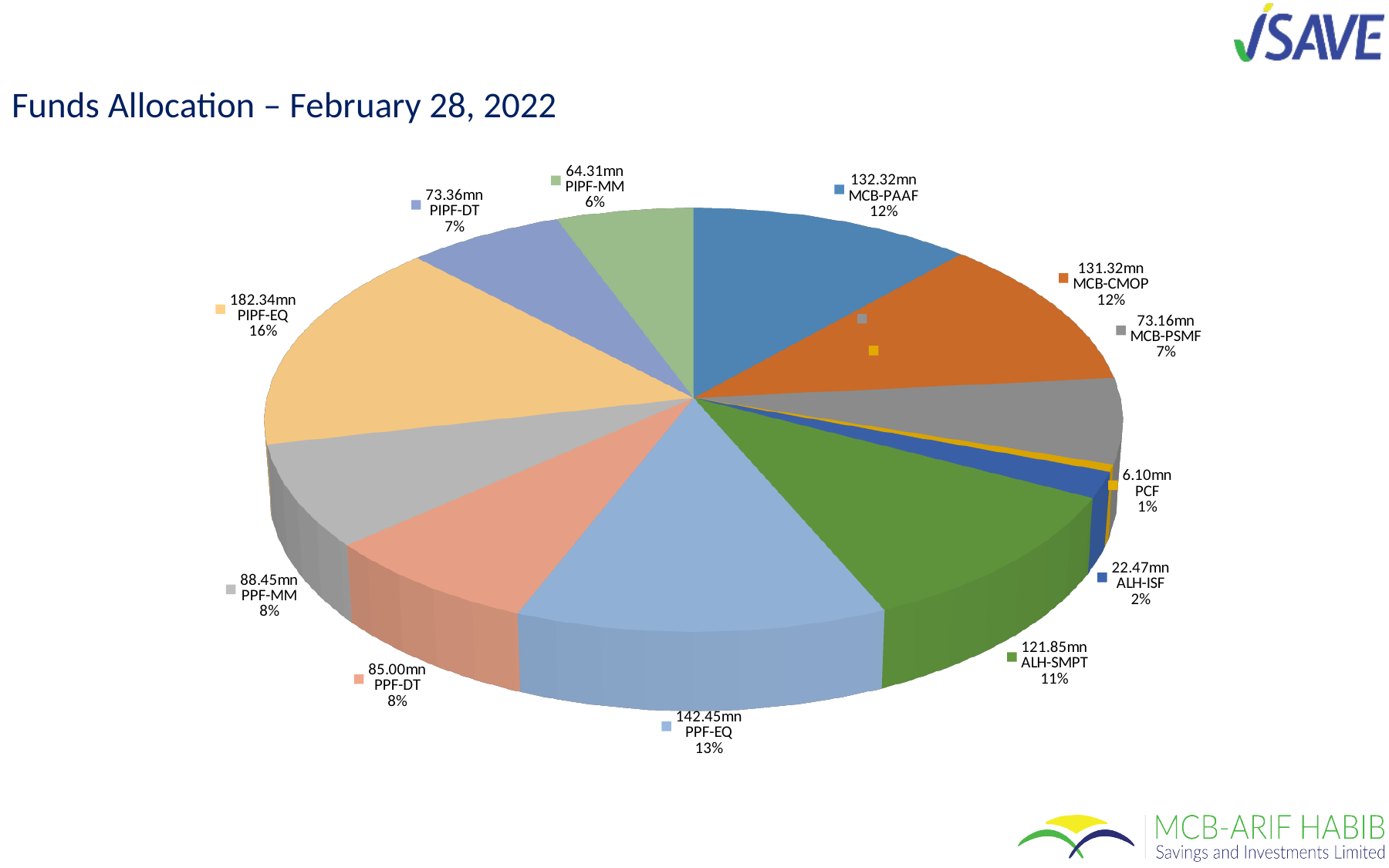
What is the value for PCF? 6.10mn What share of the pie does ALH-ISF represent? 2% What is the difference between the values for PIPF-EQ and PPF-EQ? 39.89mn What is the title of the slide? Funds Allocation – February 28, 2022 Which fund has the smallest allocation? PCF Which is larger, the value for PPF-MM or the value for PIPF-MM? PPF-MM How many funds are shown in the pie chart? 12 What is the value for PIPF-EQ? 182.34mn Which fund has the largest allocation? PIPF-EQ What share of the pie does PPF-EQ represent? 13% What type of chart is shown on the slide? pie chart What is the value for ALH-SMPT? 121.85mn